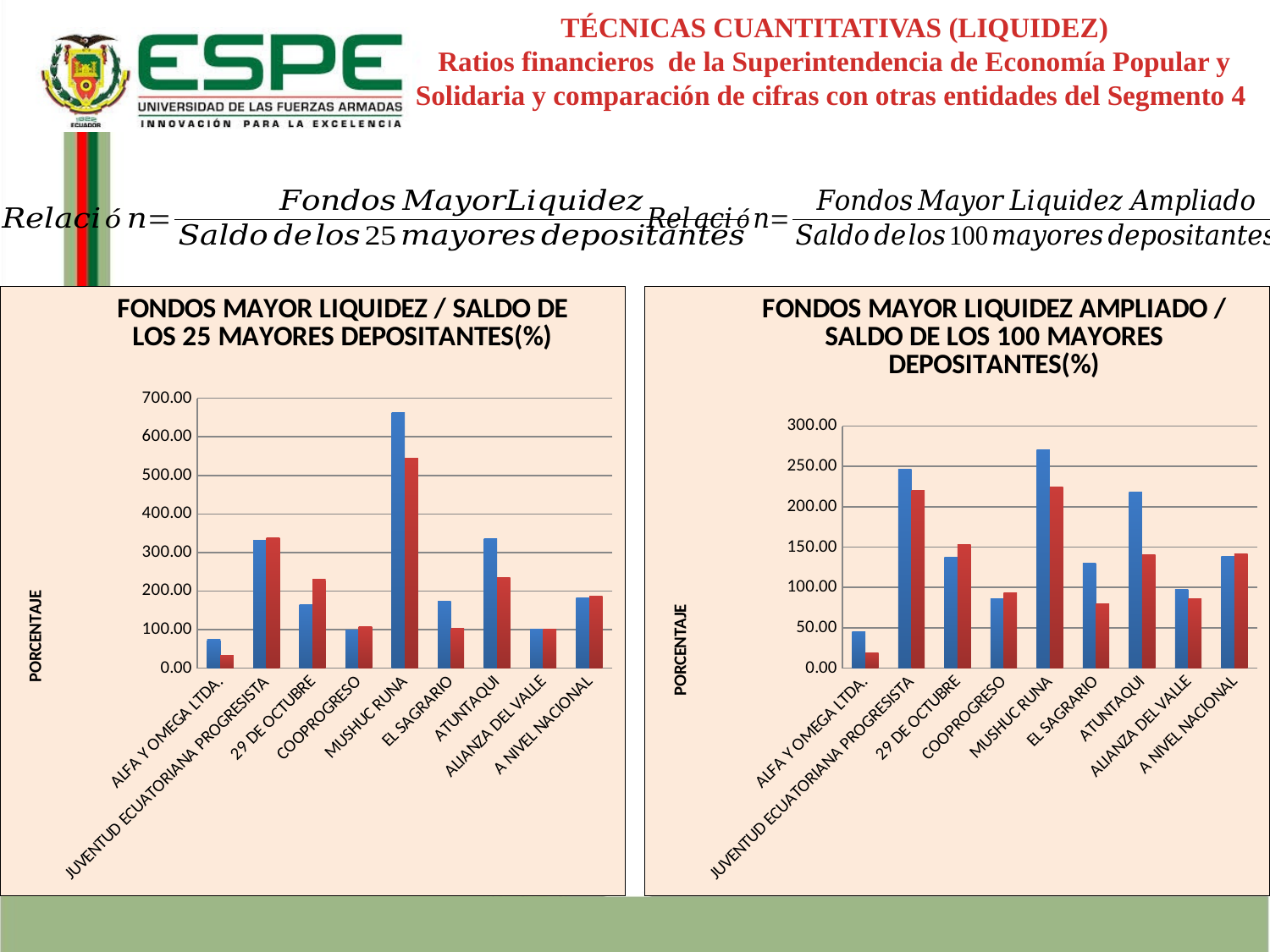
What is the y-axis title of the left chart (25 mayores depositantes)? PORCENTAJE What kind of chart is the left chart, 'FONDOS MAYOR LIQUIDEZ / SALDO DE LOS 25 MAYORES DEPOSITANTES(%)'? Bar chart In the right chart (100 mayores depositantes), which category has the lowest red bar? ALFA Y OMEGA LTDA. In the left chart (25 mayores depositantes), is the blue bar for MUSHUC RUNA greater or less than 600.00? greater In the right chart (100 mayores depositantes), is the blue bar for ATUNTAQUI greater or less than 200.00? greater In the left chart (25 mayores depositantes), which category has the highest blue bar? MUSHUC RUNA In the right chart (100 mayores depositantes), which category has the highest blue bar? MUSHUC RUNA In the right chart (100 mayores depositantes), for ATUNTAQUI, which bar is larger, the blue or the red? Blue In the right chart (100 mayores depositantes), is the red bar for EL SAGRARIO greater or less than 100.00? less In the left chart (25 mayores depositantes), which category has the lowest blue bar? ALFA Y OMEGA LTDA. How many categories are shown on the x axis of the right chart, 'FONDOS MAYOR LIQUIDEZ AMPLIADO / SALDO DE LOS 100 MAYORES DEPOSITANTES(%)'? 9